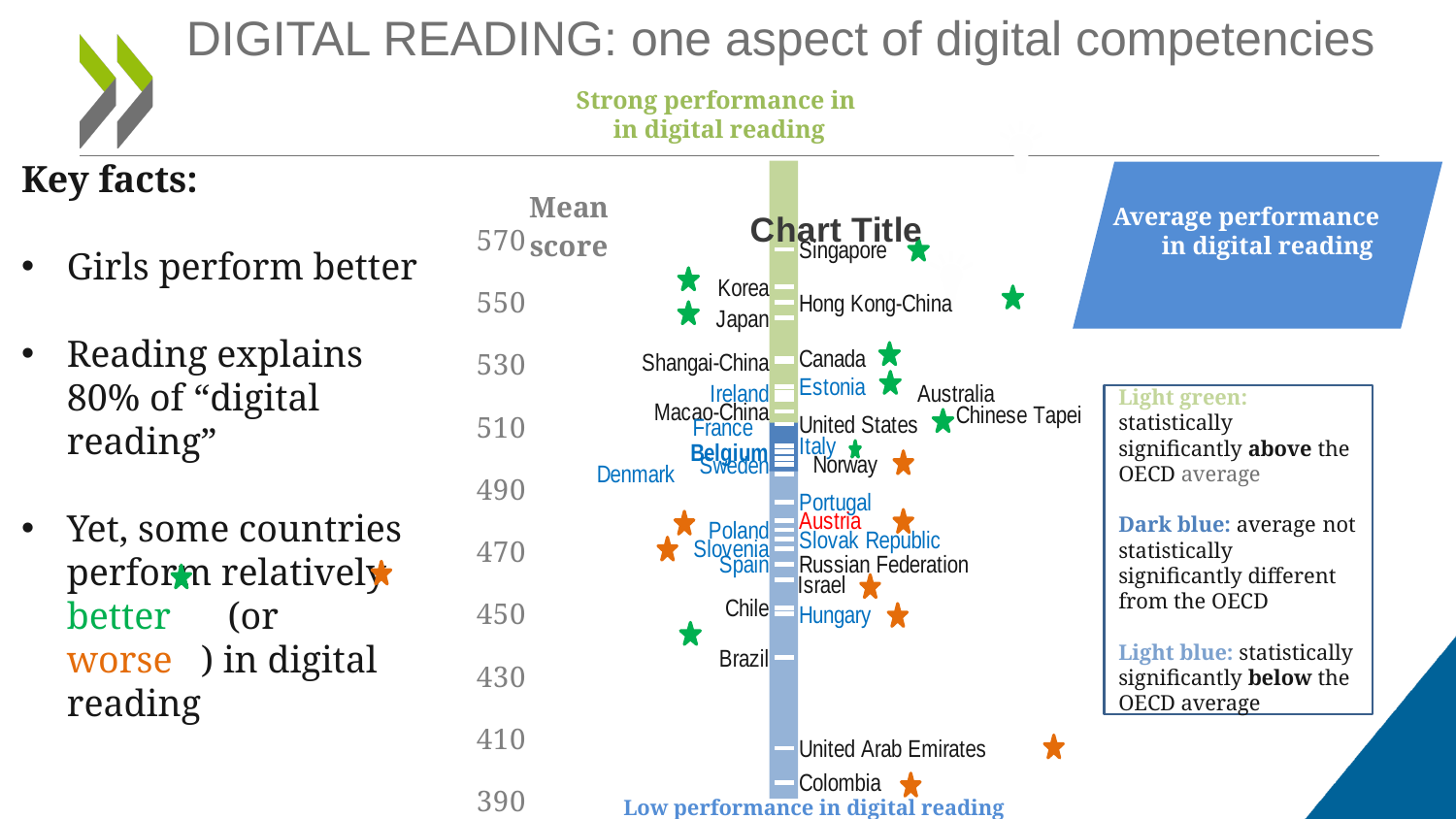
Which country has the lowest mean score in digital reading on the chart? Colombia According to the legend, what does the light green colour on the chart indicate? Statistically significantly above the OECD average Is the mean score for United Arab Emirates greater or less than 430? less Which has the higher mean score, Canada or Hungary? Canada Is the mean score for Chile greater or less than 470? less Is the mean score for Colombia greater or less than 410? less Which has the higher mean score, Singapore or Brazil? Singapore What is the label shown on the vertical axis of the chart? Mean score Which country has the highest mean score in digital reading on the chart? Singapore